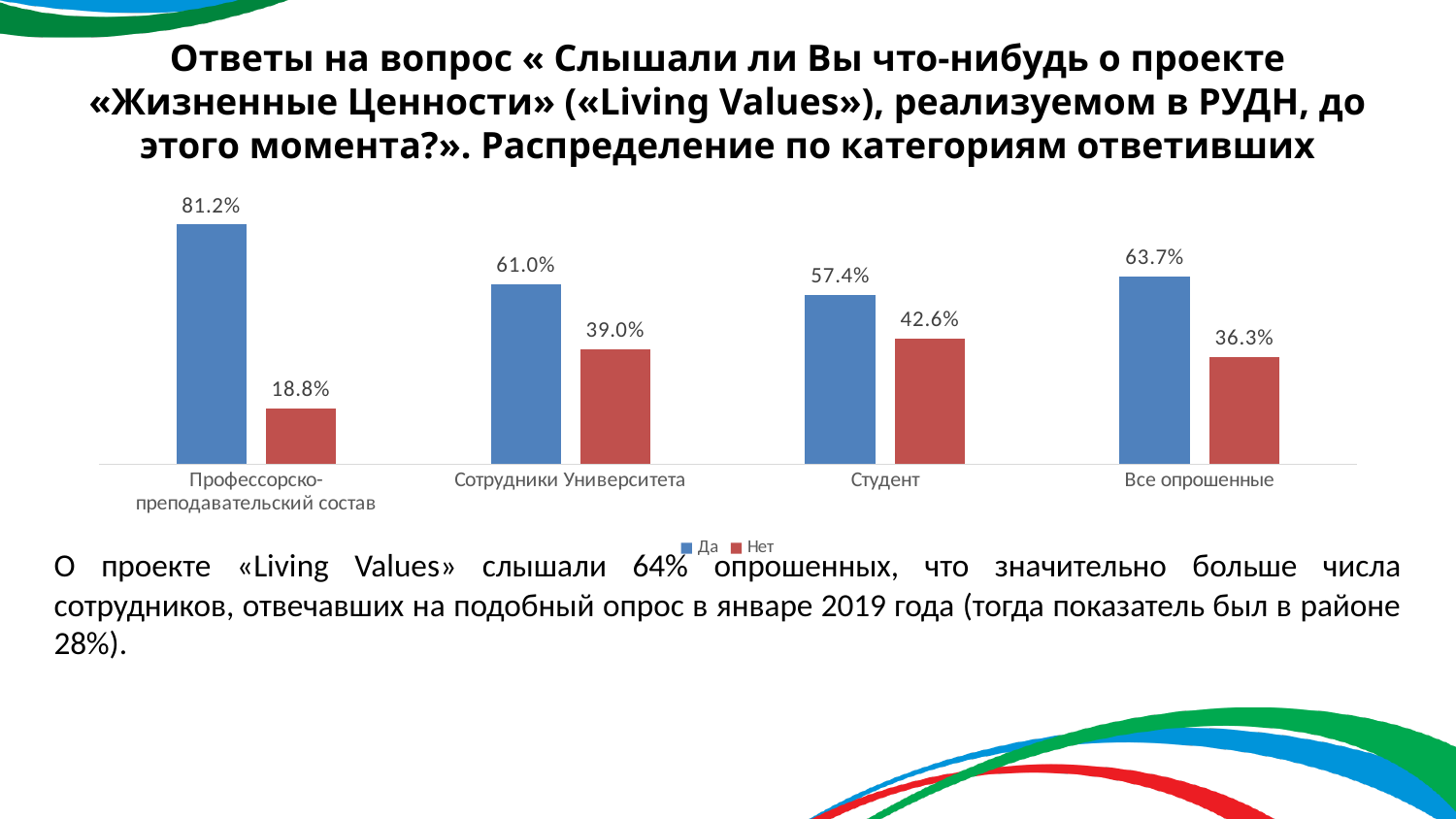
What kind of chart is shown on the slide? Bar chart What is the difference between the "Да" and "Нет" values for Студент? 14.8% What is the value of "Да" for Профессорско-преподавательский состав? 81.2% What is the value of "Да" for Все опрошенные? 63.7% How many categories are shown on the x axis? 4 Which category has the lowest "Нет" value? Профессорско-преподавательский состав What colour are the "Нет" bars? Red Which category has the highest "Да" value? Профессорско-преподавательский состав What is the value of "Нет" for Студент? 42.6% What is the value of "Нет" for Сотрудники Университета? 39.0% Which is larger: the "Да" value for Сотрудники Университета or the "Да" value for Студент? Сотрудники Университета How many series does the legend list? 2